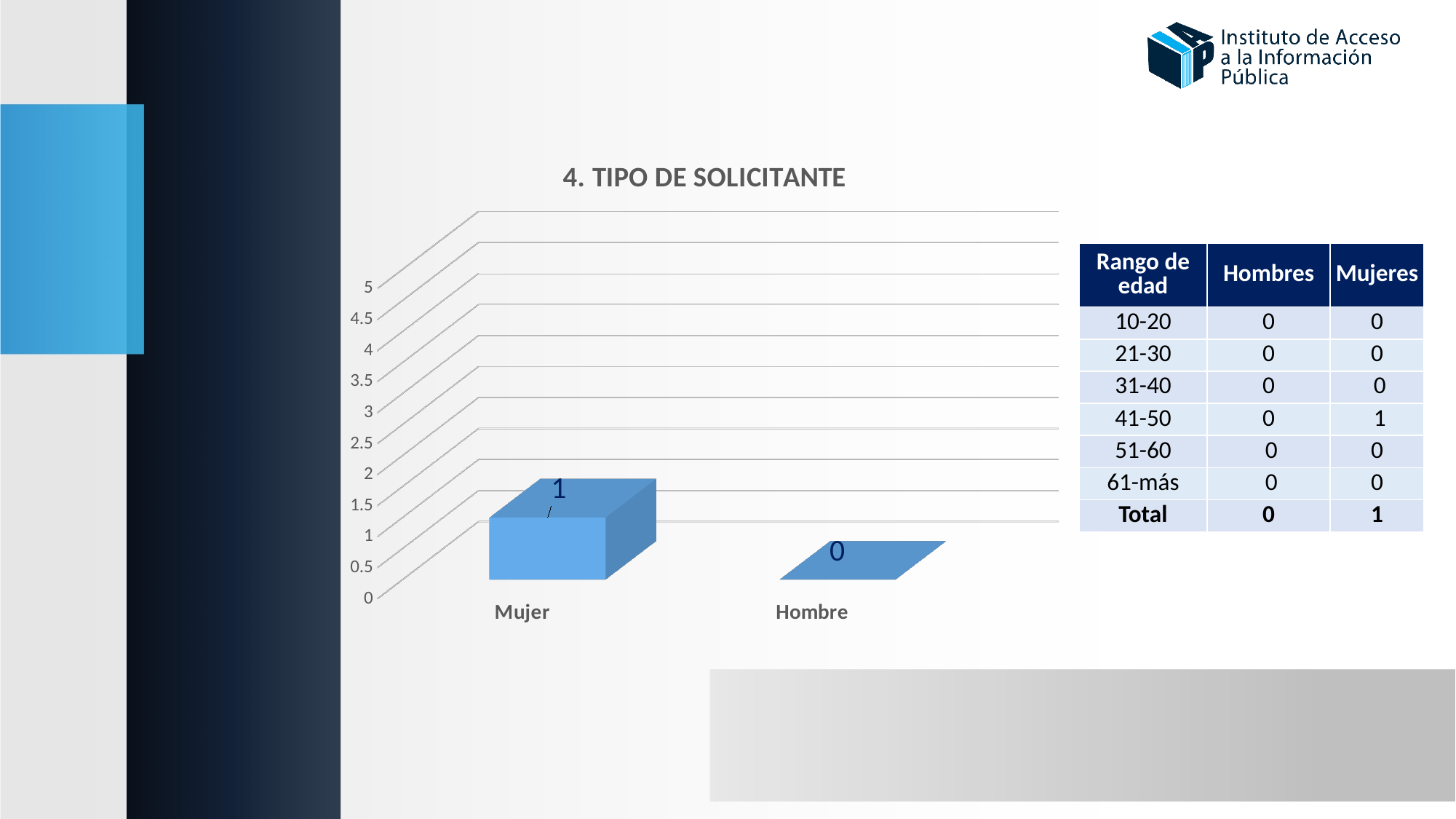
How many categories are shown on the x axis of the chart? 2 Which category has the highest value in the chart? Mujer Which category has the lowest value in the chart? Hombre What is the difference between the values for Mujer and Hombre? 1 What kind of chart is shown on the slide? bar chart Which is larger, the value for Mujer or the value for Hombre? Mujer What is the value for Hombre in the chart? 0 What is the highest value shown on the vertical axis of the chart? 5 Is the value for Mujer greater or less than 2? less What is the title of the chart? 4. TIPO DE SOLICITANTE What is the value for Mujer in the chart? 1